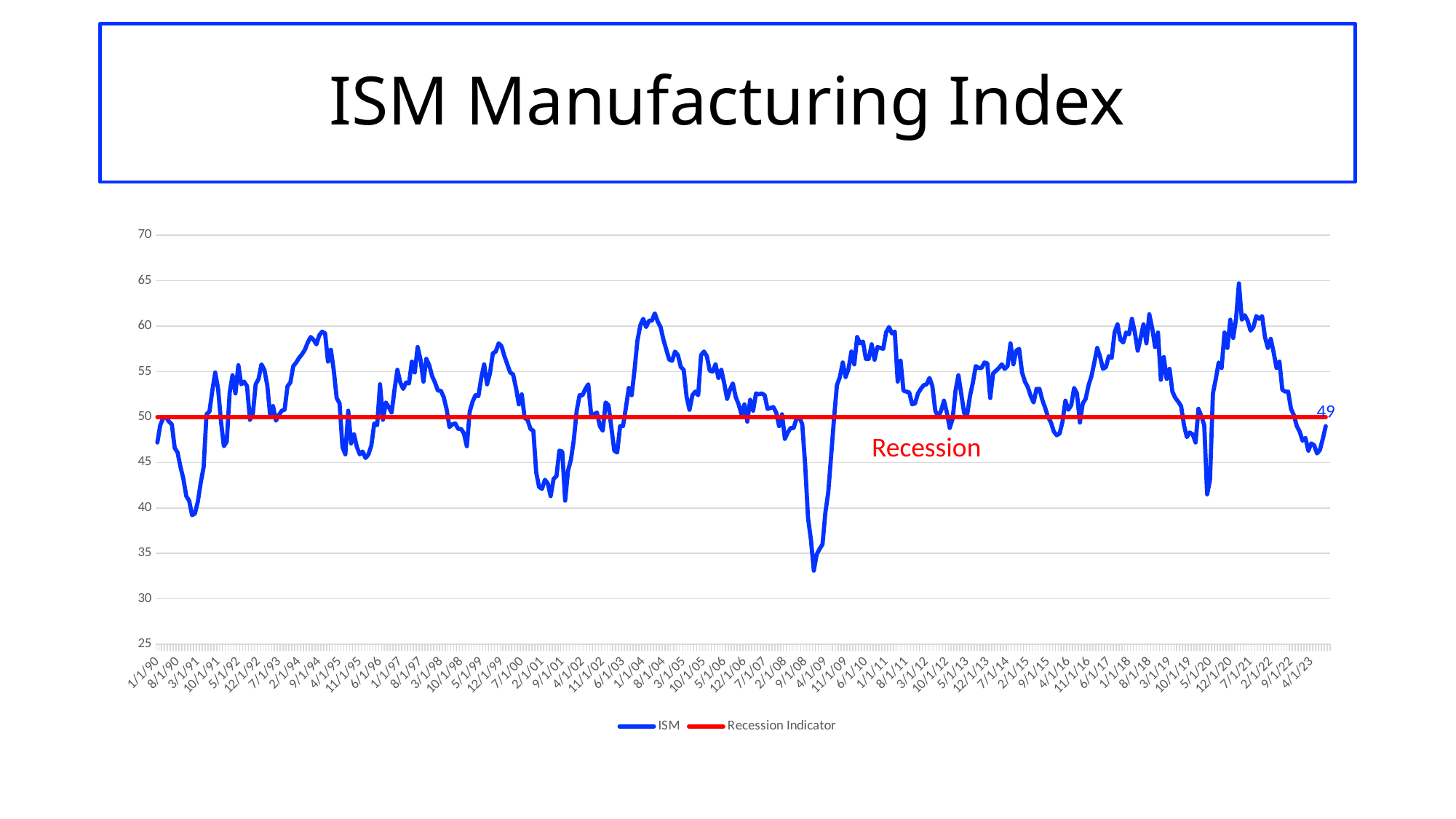
What type of chart is shown on the slide? line chart Which peak of the ISM line is higher, the one near 1/1/04 or the one near 7/1/21? 7/1/21 Is the final ISM value of 49 greater or less than the Recession Indicator level of 50? less What colour is the ISM line in the chart? blue Is the highest point of the ISM line (near 7/1/21) greater or less than 60? greater Is the lowest point of the ISM line (near 4/1/09) greater or less than 35? less Is the ISM value at 1/1/90 greater or less than 50? less At what level on the y axis is the Recession Indicator line drawn? 50 What is the title of the chart? ISM Manufacturing Index Does the ISM line rise or fall between 7/1/21 and 4/1/23? fall How many series does the legend list? 2 What is the last labelled value of the ISM line at the right end of the chart? 49